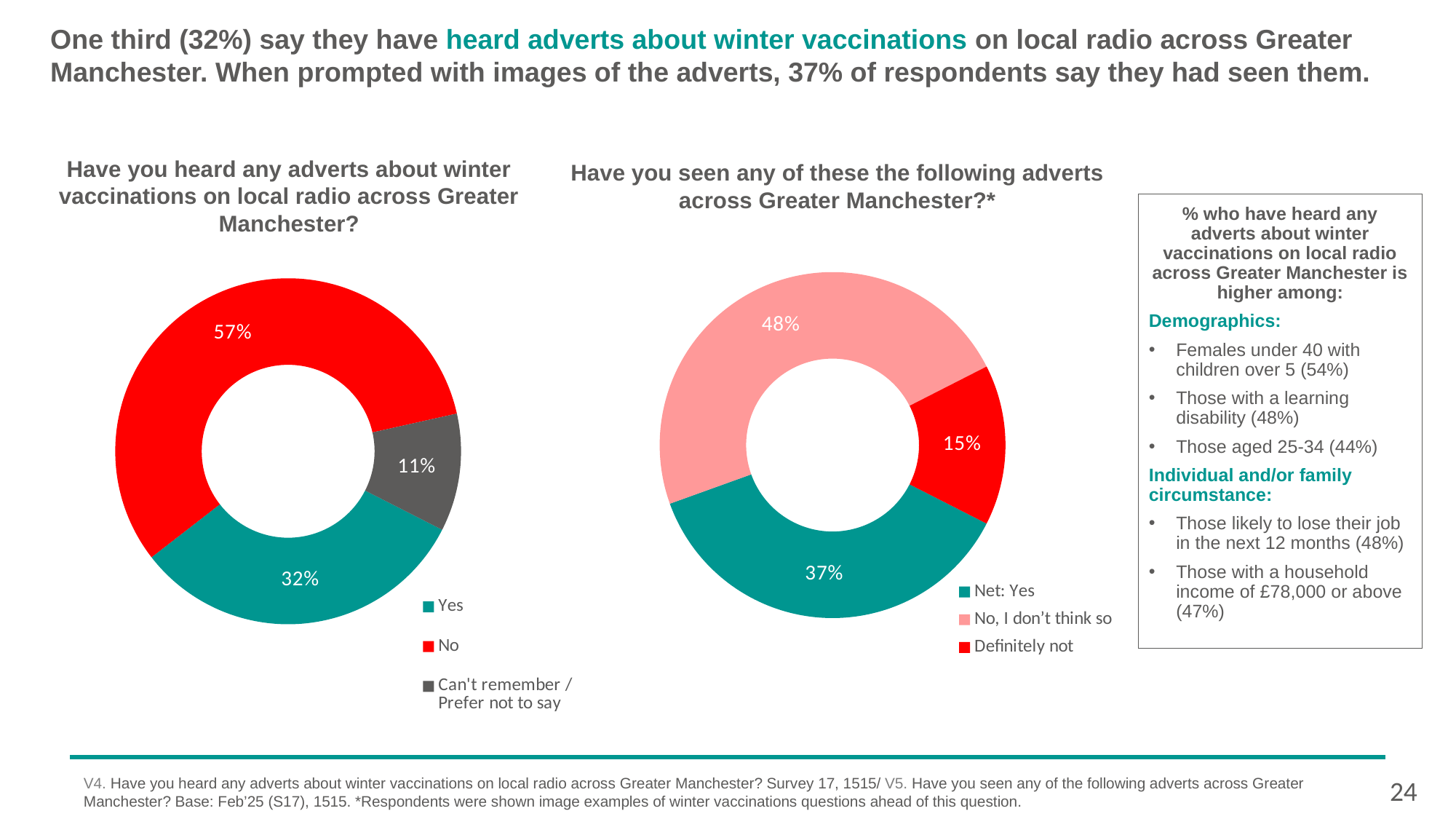
In the right chart ('Have you seen any of these the following adverts...'), what percentage is 'Definitely not'? 15% In the left chart ('Have you heard any adverts...'), which response has the smallest share? Can't remember / Prefer not to say In the right chart ('Have you seen any of these the following adverts...'), what percentage is 'No, I don't think so'? 48% In the left chart ('Have you heard any adverts...'), what percentage is 'Can't remember / Prefer not to say'? 11% In the right chart ('Have you seen any of these the following adverts across Greater Manchester?*'), what percentage is 'Net: Yes'? 37% In the left chart ('Have you heard any adverts...'), what is the difference between the 'No' and 'Yes' percentages? 25% In the left chart ('Have you heard any adverts...'), what percentage answered 'No'? 57% In the left chart ('Have you heard any adverts about winter vaccinations on local radio across Greater Manchester?'), what percentage answered 'Yes'? 32% In the left chart ('Have you heard any adverts...'), which response has the largest share? No How many categories does the legend of the right chart ('Have you seen any of these the following adverts...') list? 3 In the right chart ('Have you seen any of these the following adverts...'), which is larger: 'Net: Yes' or 'Definitely not'? Net: Yes What type of chart is the left chart ('Have you heard any adverts...')? Doughnut (pie) chart